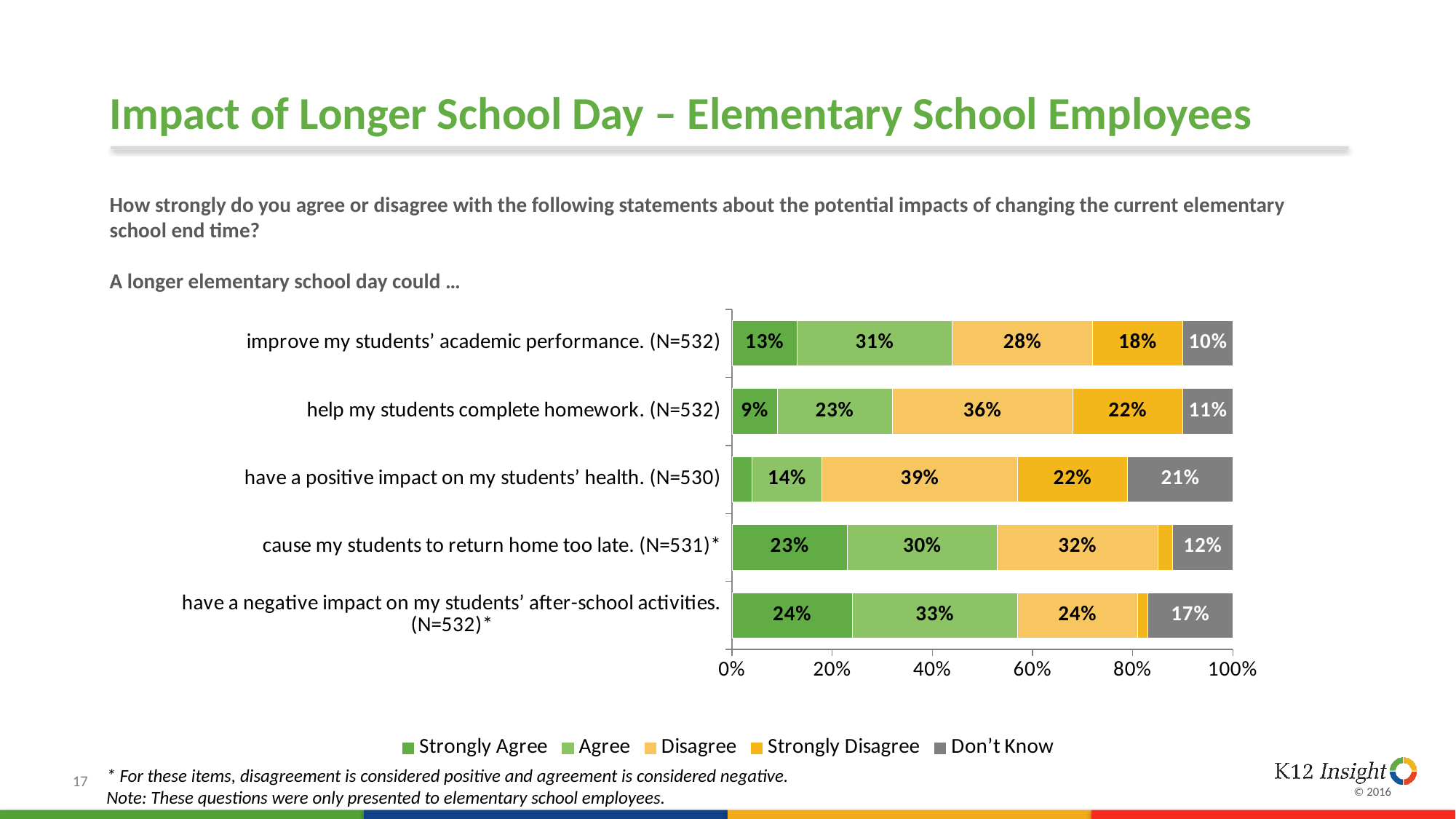
What is the total of all segments in the bar for "improve my students' academic performance"? 100% Is the Strongly Agree value for "have a positive impact on my students' health" greater or less than 20%? less Which statement has the highest Disagree percentage? have a positive impact on my students' health. Which statement has the larger Strongly Disagree share: "help my students complete homework" or "improve my students' academic performance"? help my students complete homework. Which statement has the lowest Don't Know percentage? improve my students' academic performance. How many response categories does the legend list? 5 What type of chart is shown on the slide? Stacked bar chart For "improve my students' academic performance", how many percentage points higher is Agree than Strongly Agree? 18 percentage points What is the Don't Know value for the statement "have a positive impact on my students' health"? 21% What percentage of respondents chose Disagree for the statement "help my students complete homework"? 36% What percentage chose Strongly Agree for "have a negative impact on my students' after-school activities"? 24% How many statements are shown in the chart? 5